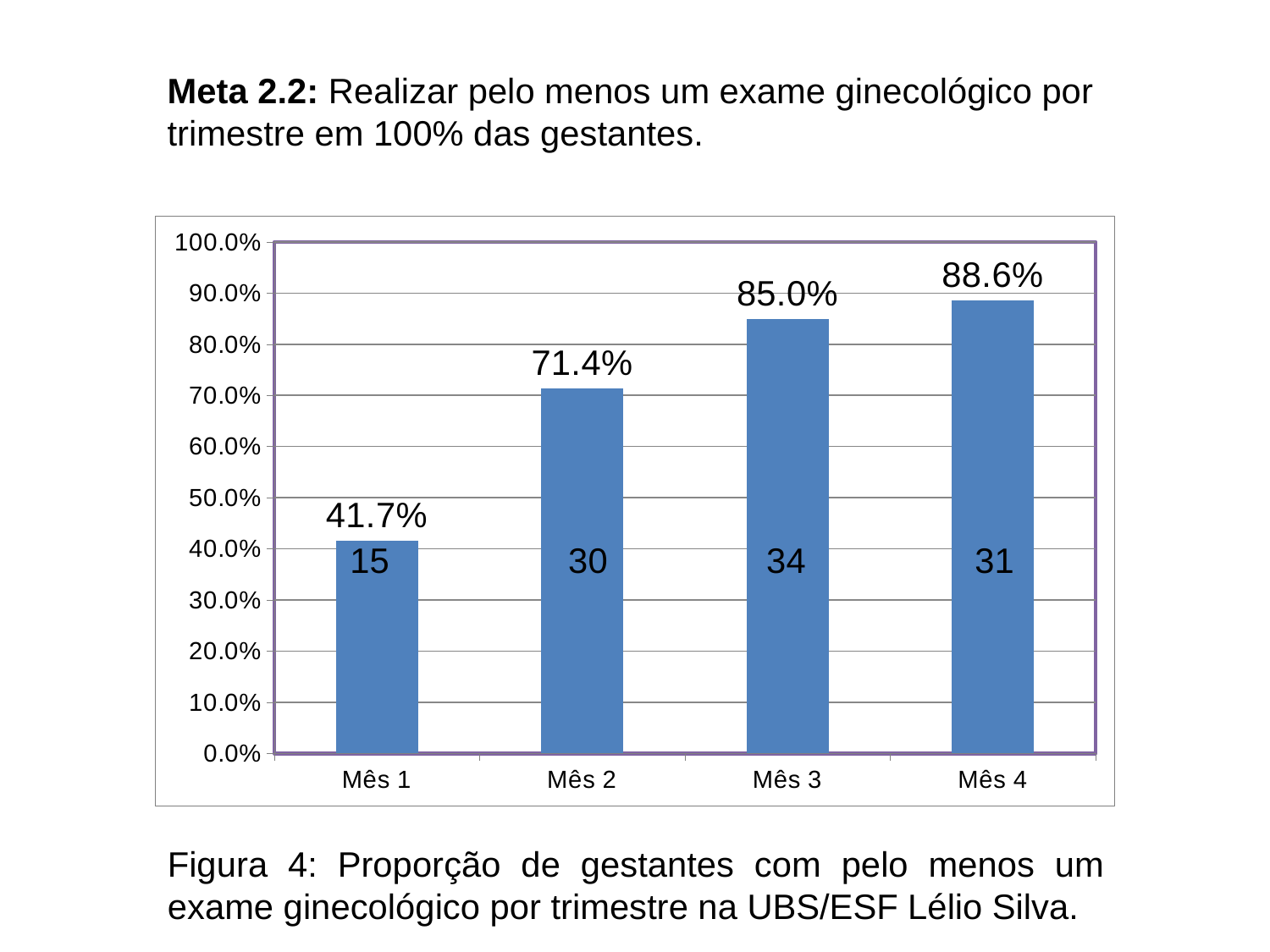
What is the difference in percentage between Mês 2 and Mês 1? 29.7% Which month has the lowest percentage? Mês 1 Do the percentages rise or fall from Mês 1 to Mês 4? Rise Which month has the highest percentage? Mês 4 What is the value for Mês 1? 41.7% How many months are shown on the x axis? 4 What kind of chart is shown? Bar chart What number is printed inside the bar for Mês 2? 30 Which is larger, the percentage for Mês 2 or for Mês 3? Mês 3 What number is printed inside the bar for Mês 4? 31 What is the value for Mês 3? 85.0% What is the difference in percentage between Mês 4 and Mês 3? 3.6%